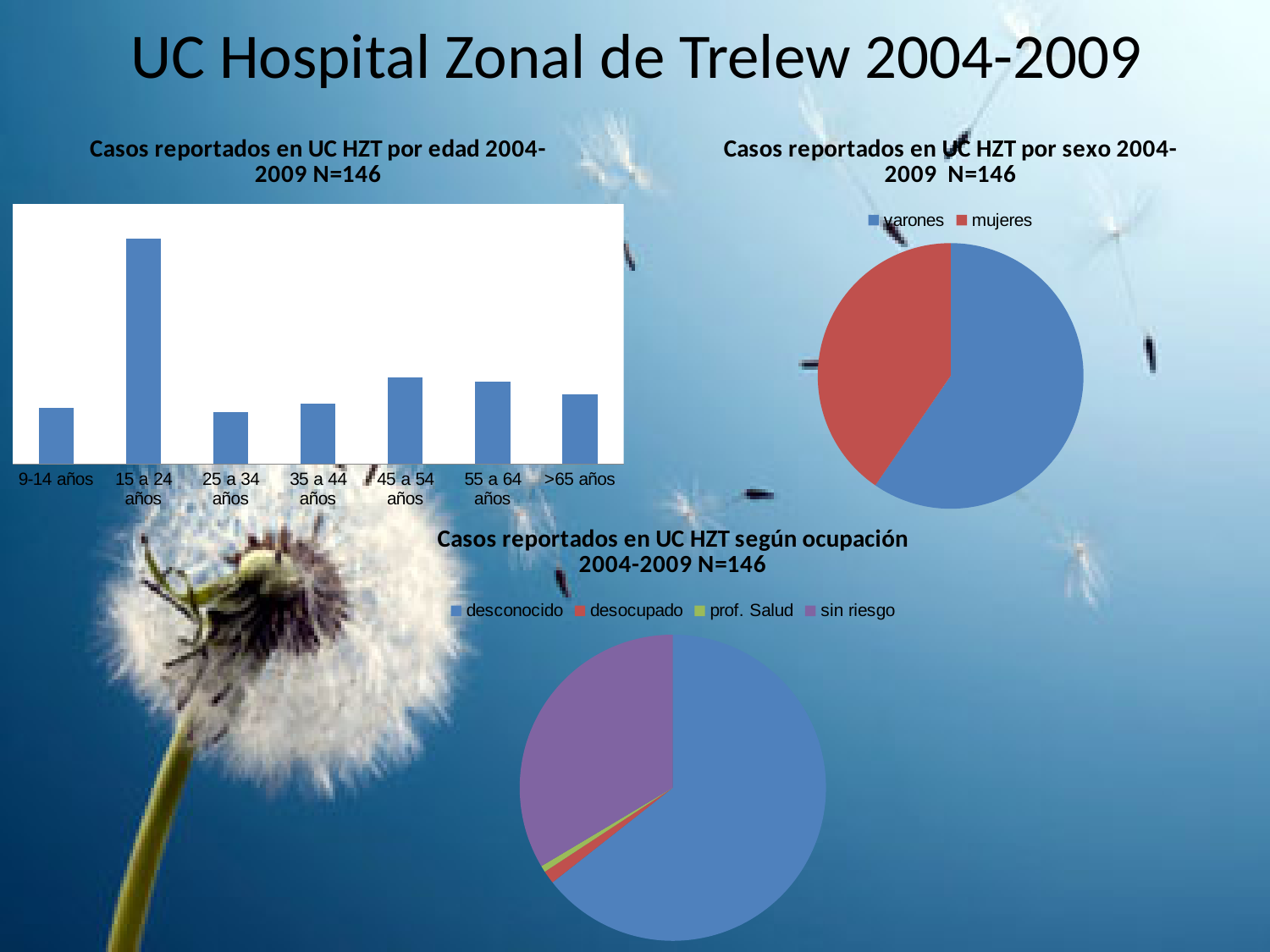
In the chart "Casos reportados en UC HZT según ocupación 2004-2009 N=146", which category has the largest slice? desconocido What kind of chart is "Casos reportados en UC HZT por sexo 2004-2009 N=146"? pie chart In the chart "Casos reportados en UC HZT por edad 2004-2009 N=146", which age group has the highest number of cases? 15 a 24 años How many entries does the legend of "Casos reportados en UC HZT por sexo 2004-2009 N=146" list? 2 In the chart "Casos reportados en UC HZT por edad 2004-2009 N=146", how many age categories are shown? 7 What kind of chart is "Casos reportados en UC HZT según ocupación 2004-2009 N=146"? pie chart In the chart "Casos reportados en UC HZT por sexo 2004-2009 N=146", which group has the larger share: varones or mujeres? varones In the chart "Casos reportados en UC HZT por edad 2004-2009 N=146", which is larger: the bar for 45 a 54 años or the bar for 35 a 44 años? 45 a 54 años What kind of chart is "Casos reportados en UC HZT por edad 2004-2009 N=146"? bar chart In the chart "Casos reportados en UC HZT por edad 2004-2009 N=146", which is larger: the bar for 15 a 24 años or the bar for >65 años? 15 a 24 años How many categories does the legend of "Casos reportados en UC HZT según ocupación 2004-2009 N=146" list? 4 In the chart "Casos reportados en UC HZT según ocupación 2004-2009 N=146", what colour is the slice for sin riesgo? purple